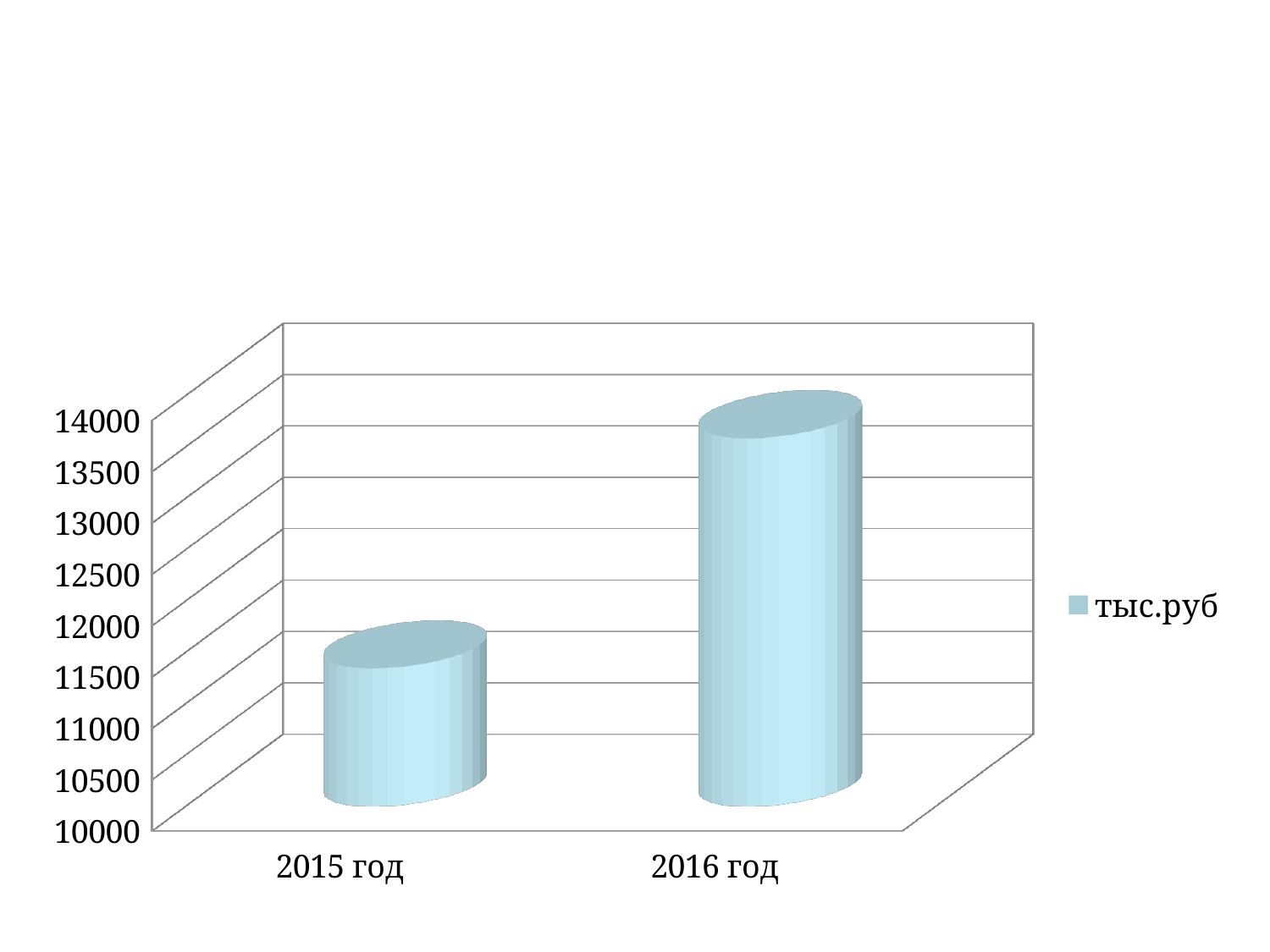
Which is larger, the value for 2015 год or 2016 год? 2016 год What kind of chart is shown on the slide? bar chart What are the category labels on the x axis? 2015 год, 2016 год Which year has the highest value? 2016 год Do the values rise or fall from 2015 год to 2016 год? rise What is the legend entry for the series? тыс.руб Is the value for 2015 год greater or less than 10500? greater Is the value for 2016 год greater or less than 12500? greater How many series does the legend list? 1 Which year has the lowest value? 2015 год Is the value for 2015 год greater or less than 13000? less How many categories are shown on the x axis? 2